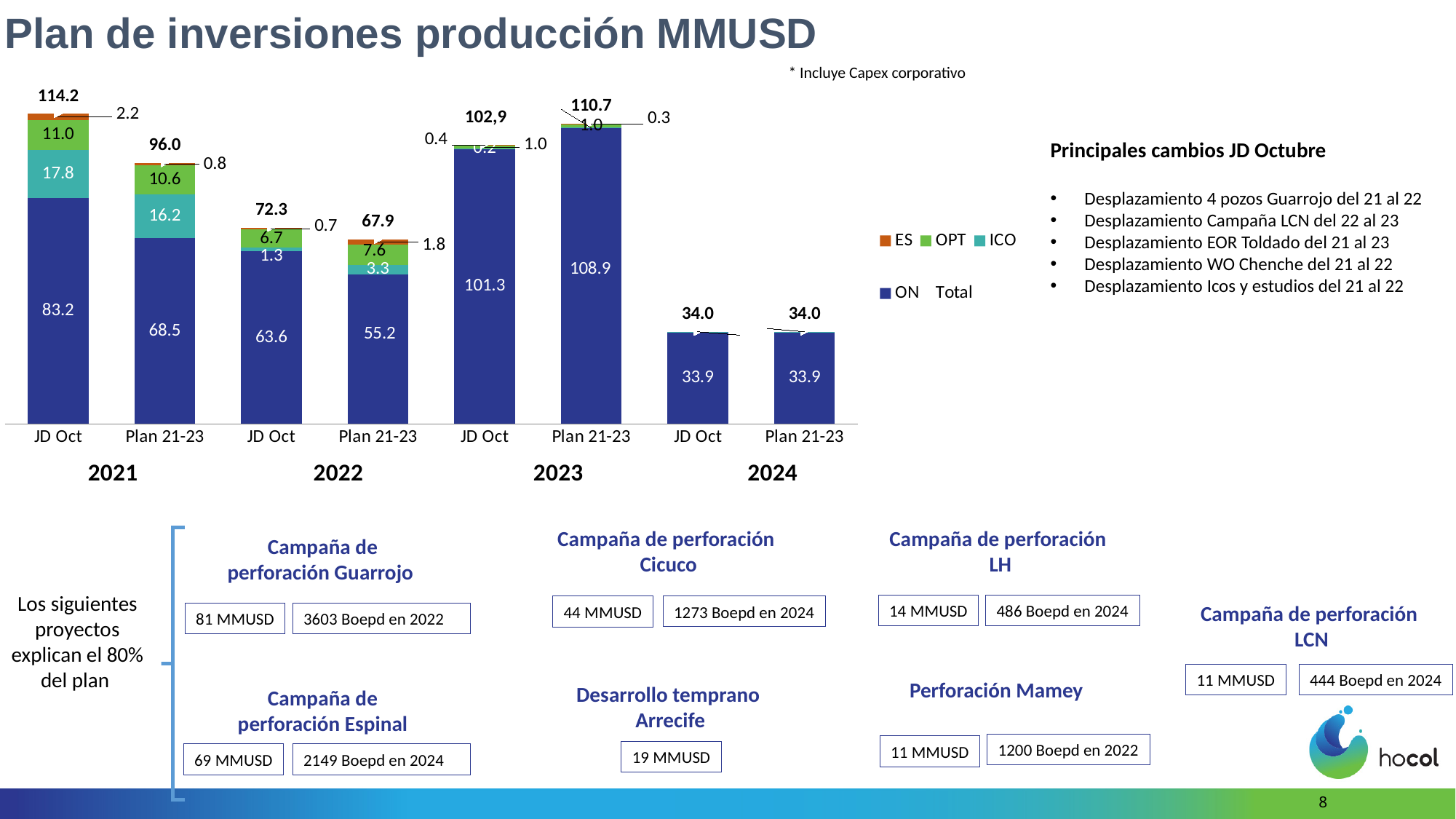
What is the total value for the JD Oct bar in 2021? 114.2 What is the OPT value for the Plan 21-23 bar in 2021? 10.6 What is the difference between the JD Oct total and the Plan 21-23 total in 2021? 18.2 How many entries does the legend list? 5 Which year has the lowest total values? 2024 In 2023, which bar has the larger ON value, JD Oct or Plan 21-23? Plan 21-23 What is the ES value for the Plan 21-23 bar in 2022? 1.8 What kind of chart is shown on the slide? Stacked bar chart Which bar has the highest total value? JD Oct 2021 (114.2) How many bars are plotted in the chart? 8 What is the ON value for the Plan 21-23 bar in 2022? 55.2 What is the ICO value for the JD Oct bar in 2021? 17.8